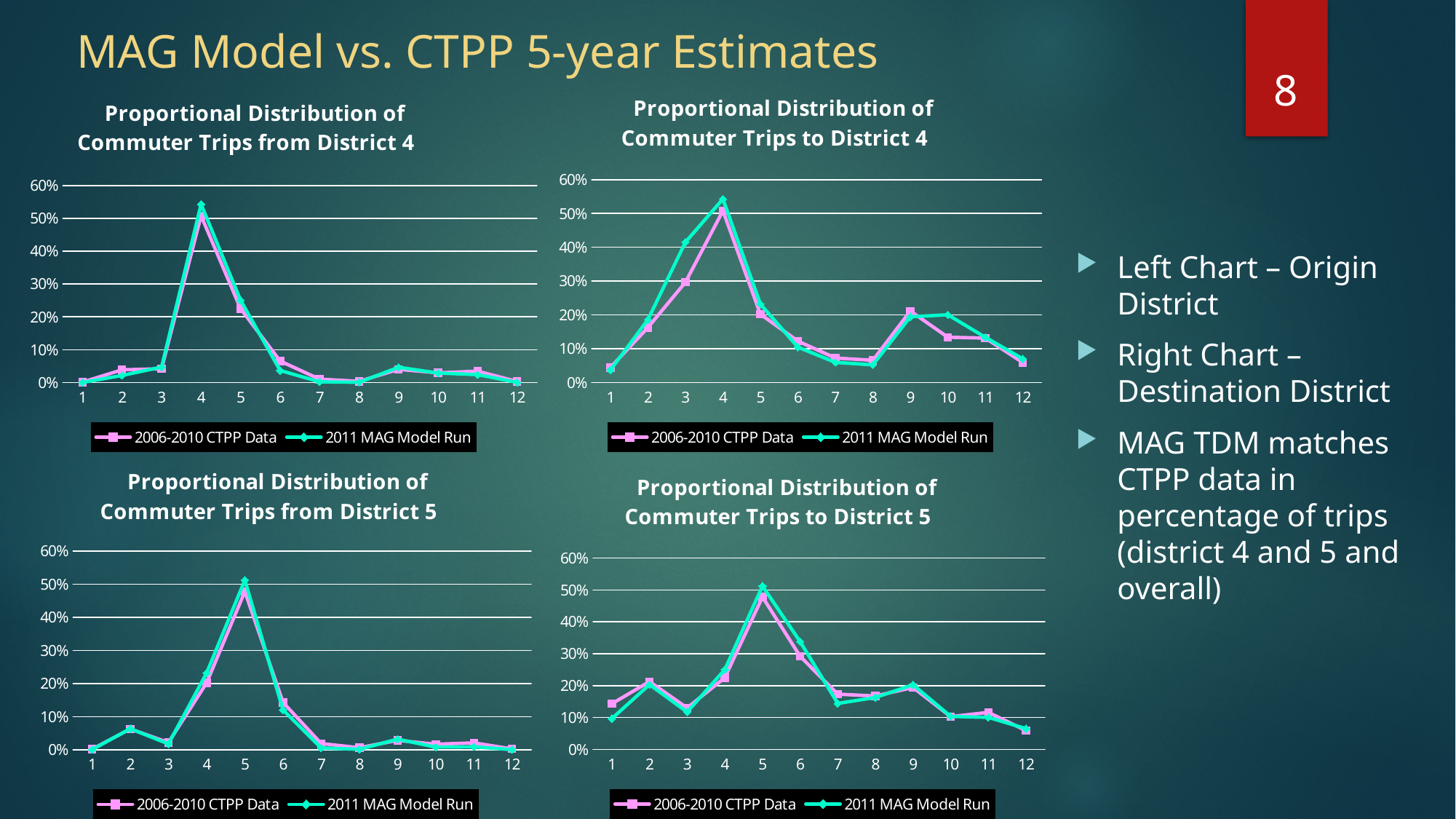
How many districts are plotted along the x axis of the bottom-left chart, 'Proportional Distribution of Commuter Trips from District 5'? 12 What colour is the 2006-2010 CTPP Data line in the charts on the slide? pink In the top-left chart, 'Proportional Distribution of Commuter Trips from District 4', which district has the highest value for the 2011 MAG Model Run series? 4 In the bottom-left chart, 'Proportional Distribution of Commuter Trips from District 5', is the 2006-2010 CTPP Data value for district 6 greater or less than 10%? greater In the bottom-right chart, 'Proportional Distribution of Commuter Trips to District 5', which series has the larger value at district 1, 2006-2010 CTPP Data or 2011 MAG Model Run? 2006-2010 CTPP Data In the top-right chart, 'Proportional Distribution of Commuter Trips to District 4', is the 2006-2010 CTPP Data value for district 1 greater or less than 10%? less What kind of chart is the top-left chart, 'Proportional Distribution of Commuter Trips from District 4'? line chart In the bottom-left chart, 'Proportional Distribution of Commuter Trips from District 5', do the 2011 MAG Model Run values rise or fall from district 5 to district 8? fall In the top-left chart, 'Proportional Distribution of Commuter Trips from District 4', is the 2011 MAG Model Run value for district 4 greater or less than 50%? greater How many series does the legend list in the top-right chart, 'Proportional Distribution of Commuter Trips to District 4'? 2 In the bottom-right chart, 'Proportional Distribution of Commuter Trips to District 5', which district has the highest value for the 2006-2010 CTPP Data series? 5 In the top-right chart, 'Proportional Distribution of Commuter Trips to District 4', which series has the larger value at district 10, 2006-2010 CTPP Data or 2011 MAG Model Run? 2011 MAG Model Run